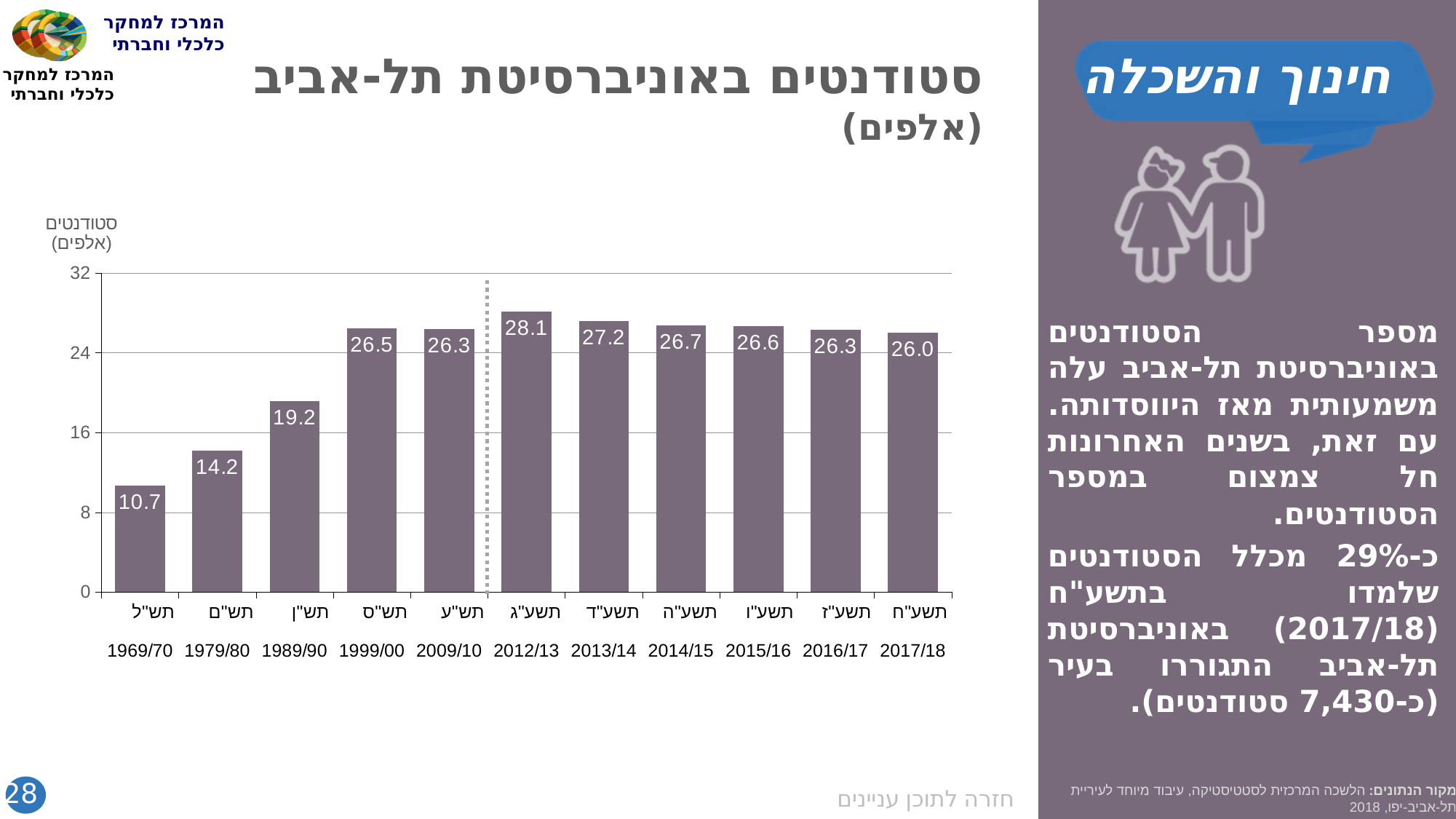
Which academic year has the lowest number of students? 1969/70 Which year has more students, 1999/00 or 2009/10? 1999/00 What is the number of students (thousands) at Tel Aviv University in 1969/70? 10.7 What kind of chart is shown on the slide? Bar chart How many academic years are shown on the chart? 11 What is the number of students (thousands) at Tel Aviv University in 2012/13? 28.1 What is the difference in students (thousands) between 1989/90 and 1979/80? 5.0 Which academic year has the highest number of students? 2012/13 What is the difference in students (thousands) between 2012/13 and 2017/18? 2.1 What is the number of students (thousands) at Tel Aviv University in 2017/18? 26.0 Is the value for 1989/90 greater or less than 16? greater Do the values rise or fall from 2012/13 to 2017/18? Fall